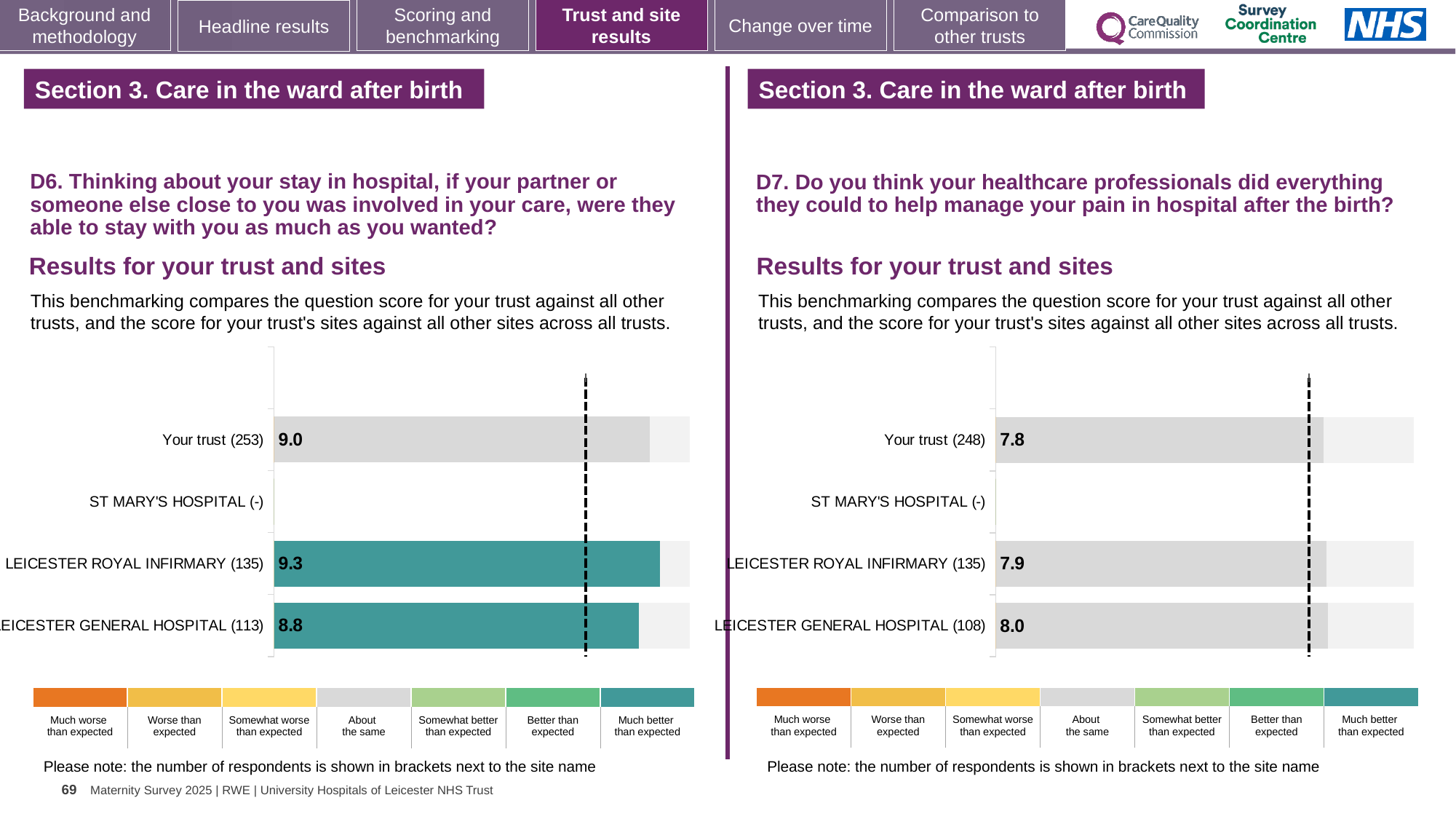
In the D6 chart on the left, which benchmark category does the colour of the LEICESTER ROYAL INFIRMARY bar correspond to in the legend? Much better than expected In the D6 chart on the left, which site or trust row has the highest score? LEICESTER ROYAL INFIRMARY (135) In the D6 chart on the left, what is the difference between the scores for LEICESTER ROYAL INFIRMARY and LEICESTER GENERAL HOSPITAL? 0.5 In the D7 chart on the right, what is the score for LEICESTER GENERAL HOSPITAL (108)? 8.0 What type of chart is used in the D6 chart on the left? Bar chart In the D6 chart on the left, what is the score for LEICESTER GENERAL HOSPITAL (113)? 8.8 In the D6 chart on the left, what is the score for LEICESTER ROYAL INFIRMARY (135)? 9.3 In the D6 chart on the left, how many rows (trust and sites) are listed on the axis? 4 In the D6 chart on the left, what is the score for Your trust (253)? 9.0 In the D7 chart on the right, what is the score for Your trust (248)? 7.8 In the D7 chart on the right, which has the larger score, LEICESTER ROYAL INFIRMARY or LEICESTER GENERAL HOSPITAL? LEICESTER GENERAL HOSPITAL In the D7 chart on the right, which row has the lowest score? Your trust (248)